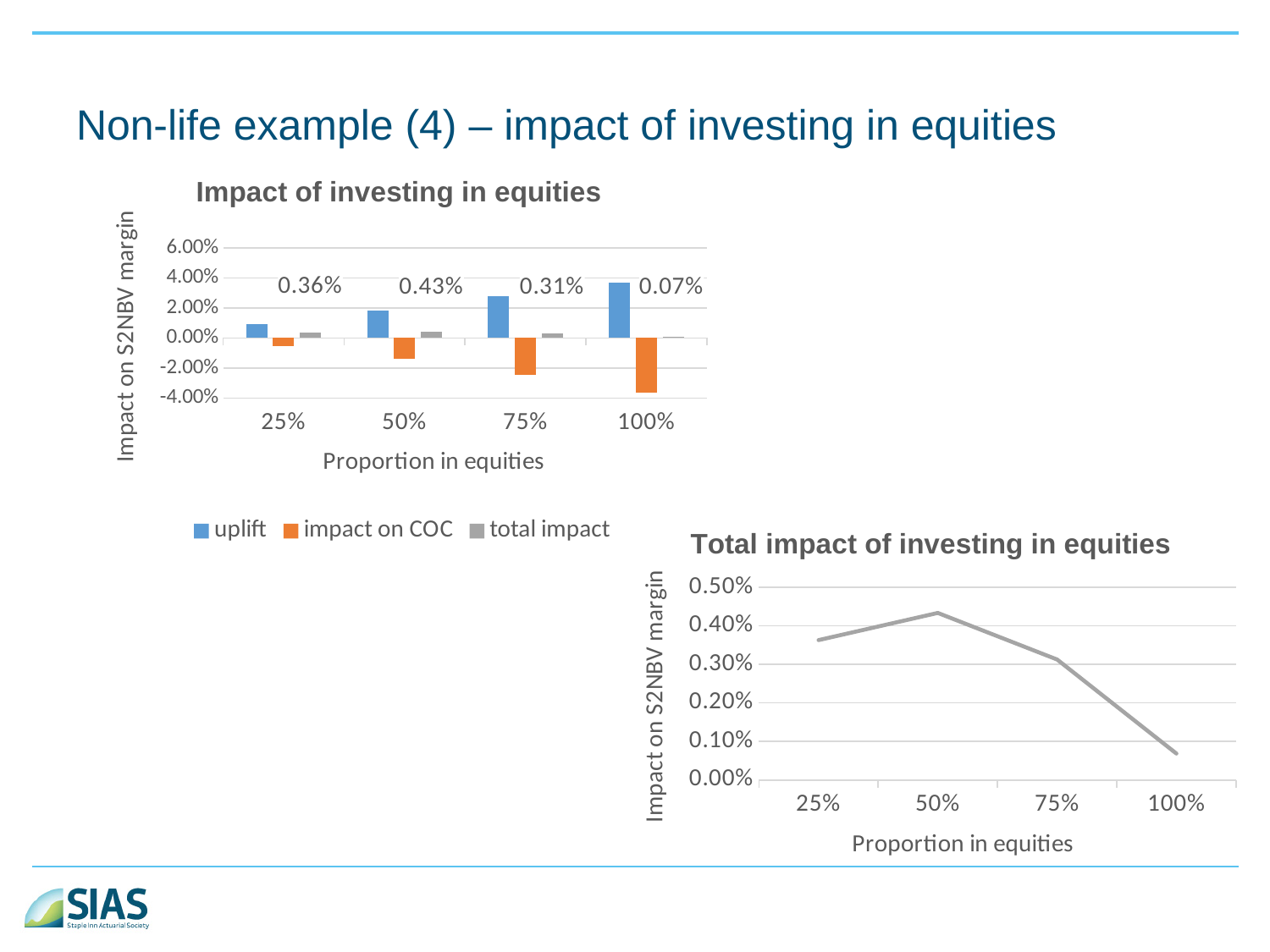
What kind of chart is 'Total impact of investing in equities'? line chart In the 'Impact of investing in equities' chart, which proportion in equities has the lowest total impact? 100% In the 'Total impact of investing in equities' chart, is the value at 100% greater or less than 0.10%? less In the 'Impact of investing in equities' chart, what is the difference between the total impact at 50% and at 25%? 0.07% In the 'Impact of investing in equities' chart, what is the total impact at 50% proportion in equities? 0.43% In the 'Total impact of investing in equities' chart, how many points are plotted on the line? 4 In the 'Impact of investing in equities' chart, what is the total impact at 100% proportion in equities? 0.07% In the 'Impact of investing in equities' chart, is the impact on COC at 75% greater or less than 0.00%? less What kind of chart is 'Impact of investing in equities'? bar chart In the 'Impact of investing in equities' chart, how many series does the legend list? 3 In the 'Impact of investing in equities' chart, which proportion in equities has the highest total impact? 50% In the 'Impact of investing in equities' chart, is the uplift at 100% greater or less than 2.00%? greater